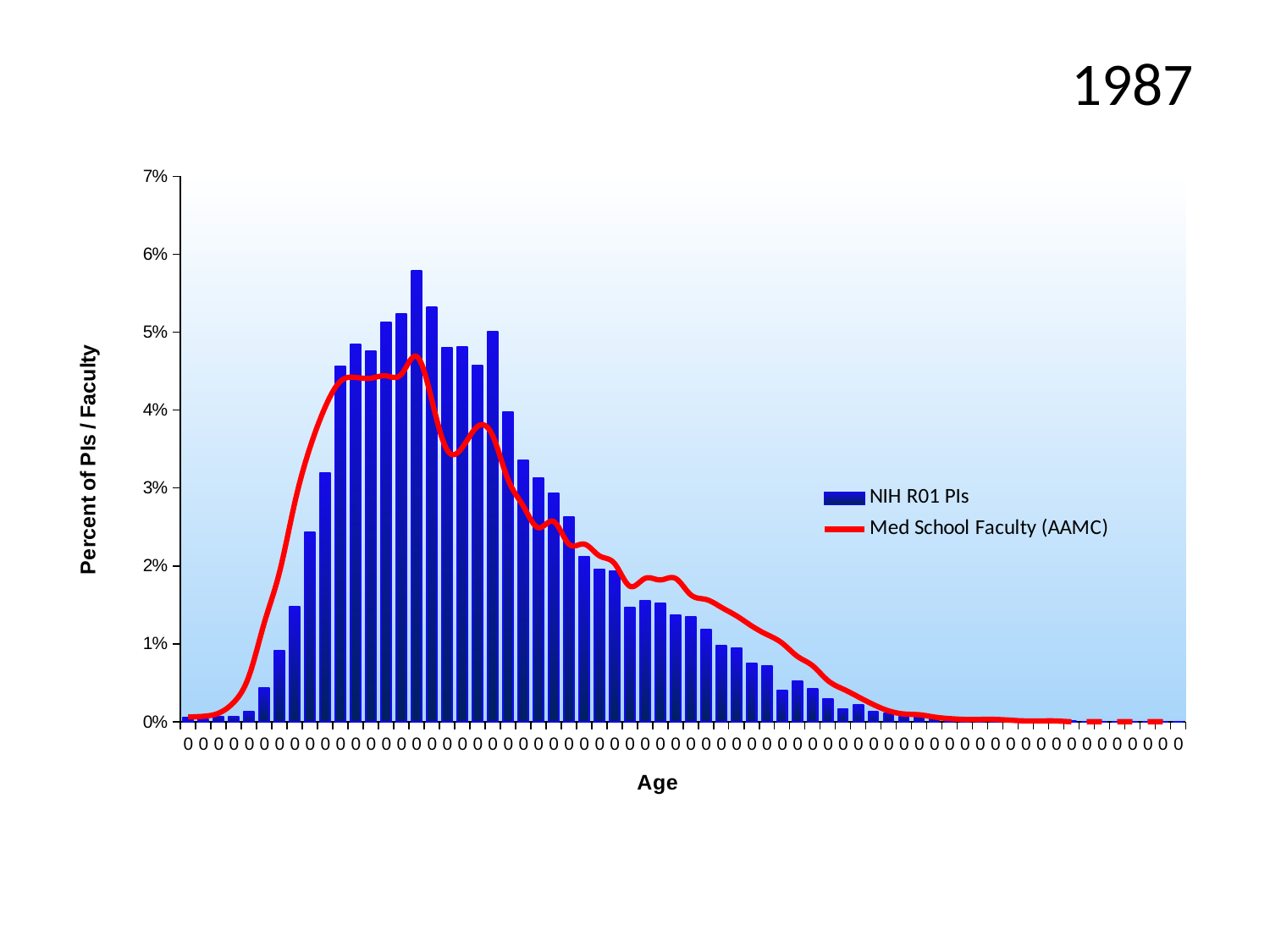
What kind of chart is shown on the slide? A bar chart combined with a line How many series does the legend list? 2 Are the values at the far right end of the x axis greater or less than 1%? less At their respective peaks, which reaches a higher percentage: the NIH R01 PIs bars or the Med School Faculty (AAMC) line? NIH R01 PIs bars Is the peak of the Med School Faculty (AAMC) line greater or less than 4%? greater Is the tallest NIH R01 PIs bar greater or less than 6%? less Which series is drawn as the red line? Med School Faculty (AAMC) Do the NIH R01 PIs values rise or fall along the x axis after their peak? fall What are the two series named in the legend? NIH R01 PIs and Med School Faculty (AAMC)